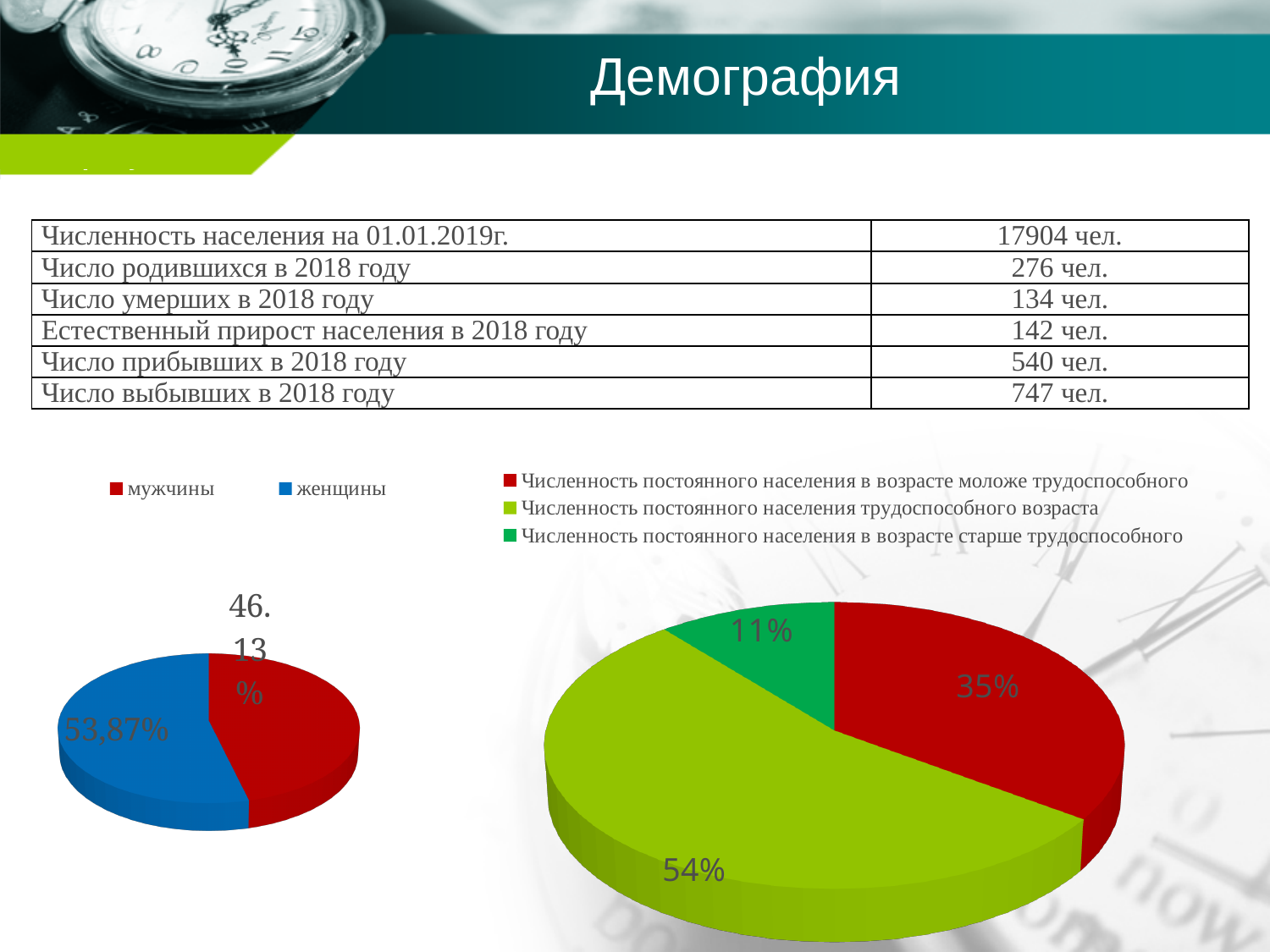
In the left pie chart, what share is shown for женщины? 53,87% In the right pie chart, how many percentage points larger is the трудоспособного возраста slice than the старше трудоспособного slice? 43 percentage points What kind of chart is the left chart (мужчины / женщины)? pie chart In the right pie chart, what share is shown for Численность постоянного населения трудоспособного возраста? 54% In the left pie chart, what share is shown for мужчины? 46.13% In the right pie chart, which category has the smallest slice? Численность постоянного населения в возрасте старше трудоспособного In the right pie chart, what share is shown for Численность постоянного населения в возрасте старше трудоспособного? 11% In the right pie chart, what share is shown for Численность постоянного населения в возрасте моложе трудоспособного? 35% How many categories does the legend of the right pie chart list? 3 What kind of chart is the right chart showing population by working age? pie chart In the right pie chart, which category has the largest slice? Численность постоянного населения трудоспособного возраста In the left pie chart, which slice is larger, мужчины or женщины? женщины